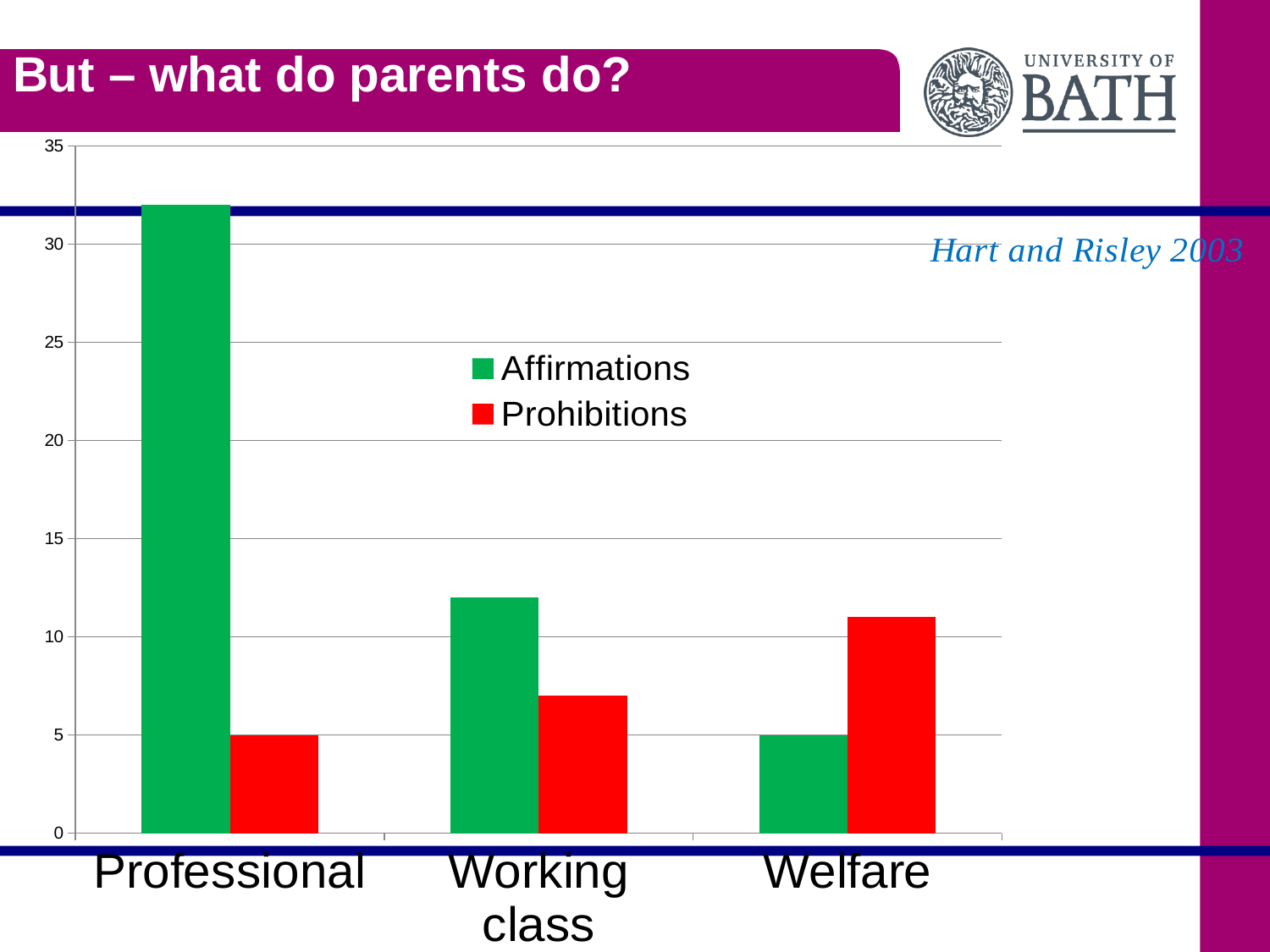
For Welfare, which is larger: Affirmations or Prohibitions? Prohibitions How many categories are shown on the x axis of the chart? 3 Is the Affirmations value for Professional greater or less than 30? greater Which category has the highest Prohibitions value? Welfare Which category has the lowest Prohibitions value? Professional Is the Affirmations value for Working class greater or less than 10? greater Which series is shown in green in the chart's legend? Affirmations Is the Prohibitions value for Welfare greater or less than 10? greater Which category has the highest Affirmations value? Professional What kind of chart is shown on the slide? bar chart How many series does the chart's legend list? 2 Which category has the lowest Affirmations value? Welfare